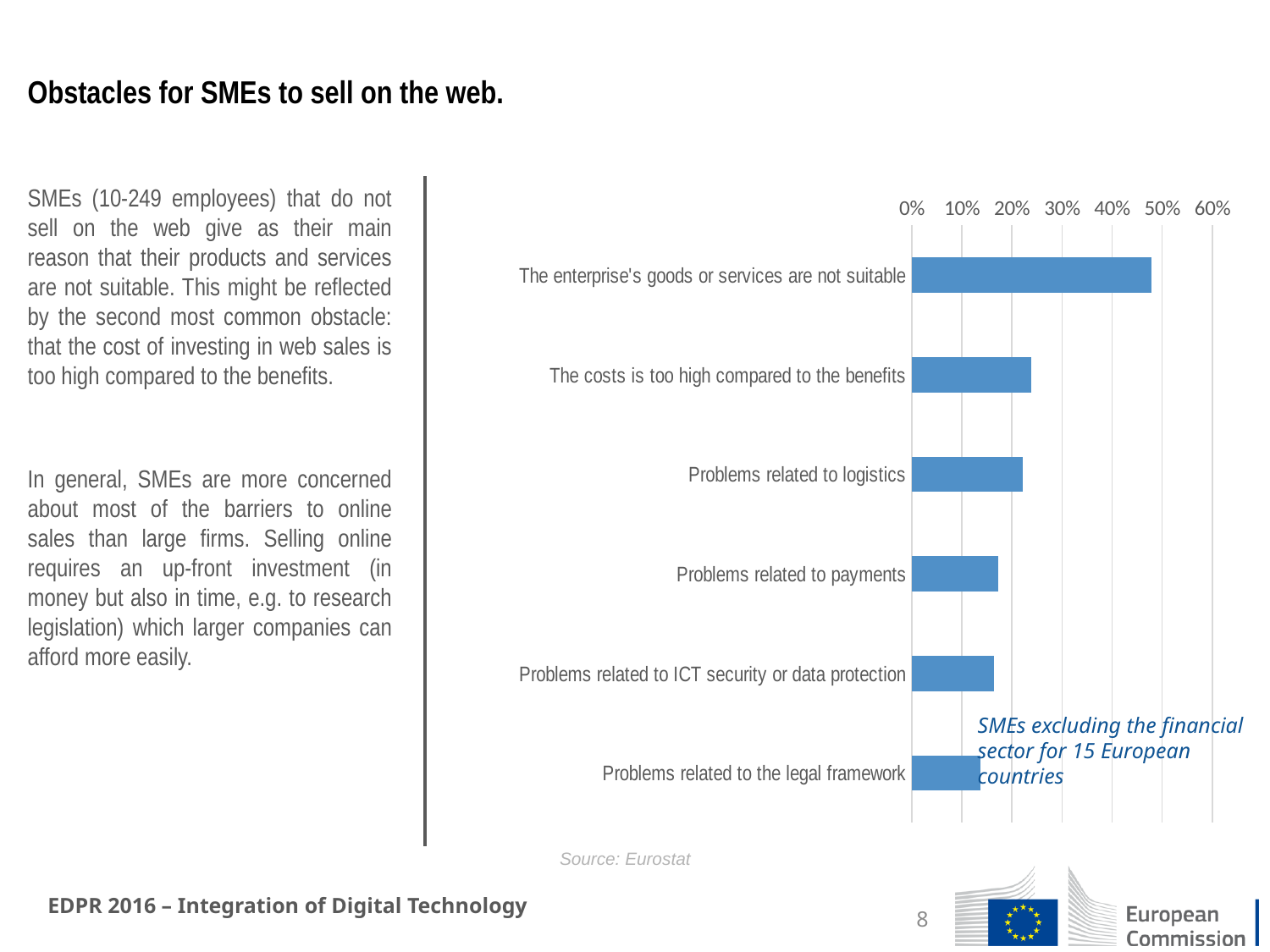
Is the value for 'Problems related to payments' greater or less than 20%? less What is the source of the data cited below the chart? Eurostat Which obstacle has the lowest value in the chart? Problems related to the legal framework Is the value for 'The costs is too high compared to the benefits' greater or less than 20%? greater What kind of chart is shown on the slide? Bar chart Which is larger: the value for 'The costs is too high compared to the benefits' or for 'Problems related to the legal framework'? The costs is too high compared to the benefits Is the value for 'Problems related to ICT security or data protection' greater or less than 20%? less How many obstacle categories are plotted in the chart? 6 Which is larger: the value for 'The enterprise's goods or services are not suitable' or for 'The costs is too high compared to the benefits'? The enterprise's goods or services are not suitable Which obstacle has the highest value in the chart? The enterprise's goods or services are not suitable